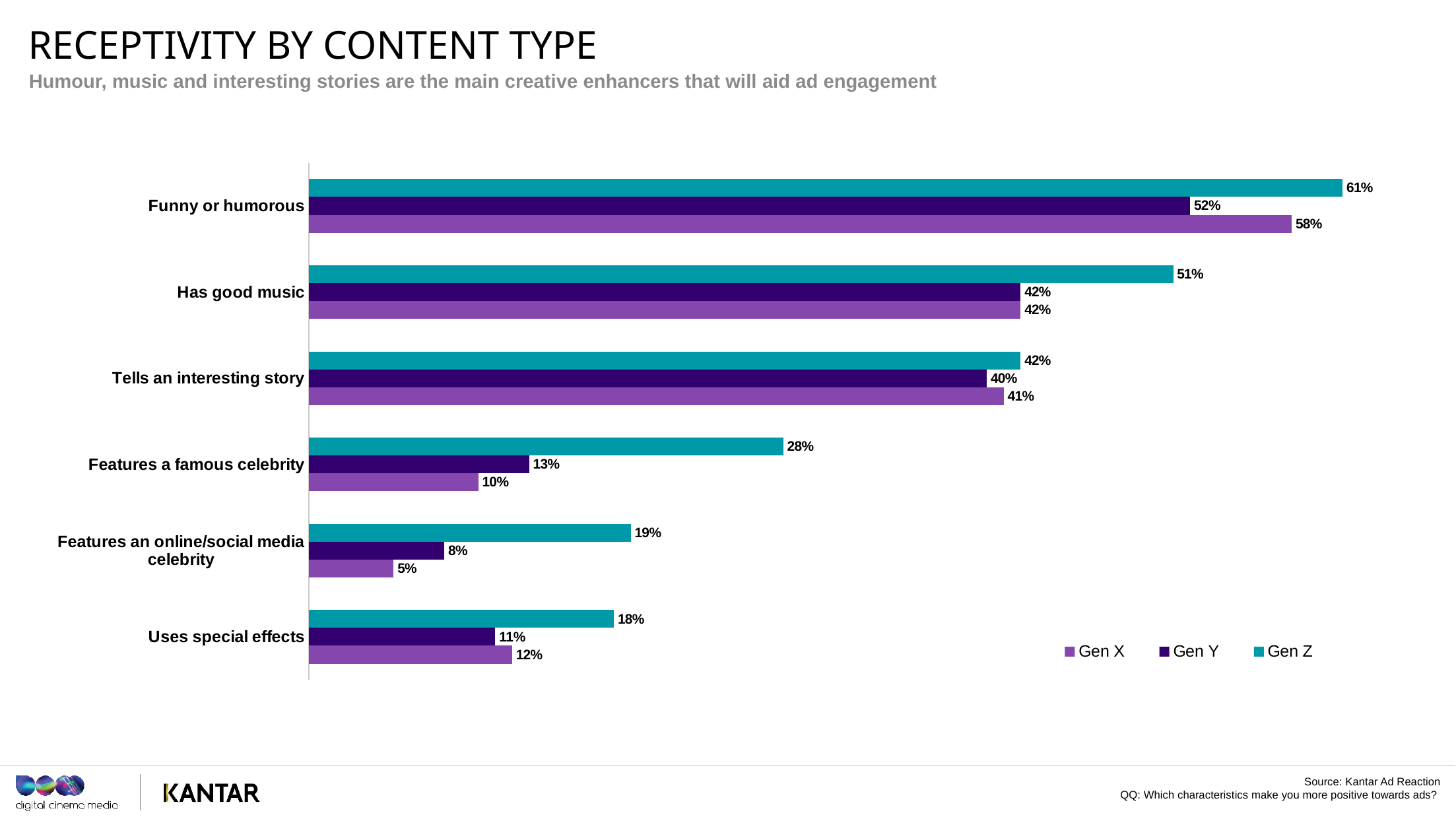
For "Funny or humorous", which is larger: the Gen X value or the Gen Y value? Gen X How many series does the legend list? 3 What is the difference between the Gen Z and Gen Y values for "Has good music"? 9% Which content type has the lowest Gen X value? Features an online/social media celebrity For "Uses special effects", which is larger: the Gen X value or the Gen Y value? Gen X What kind of chart is shown on the slide? Bar chart What is the Gen Y value for "Features a famous celebrity"? 13% What is the Gen Z value for "Funny or humorous"? 61% Which content type has the highest Gen Z value? Funny or humorous How many content types are shown on the chart? 6 Which series is shown in teal in the legend? Gen Z What is the Gen X value for "Features an online/social media celebrity"? 5%